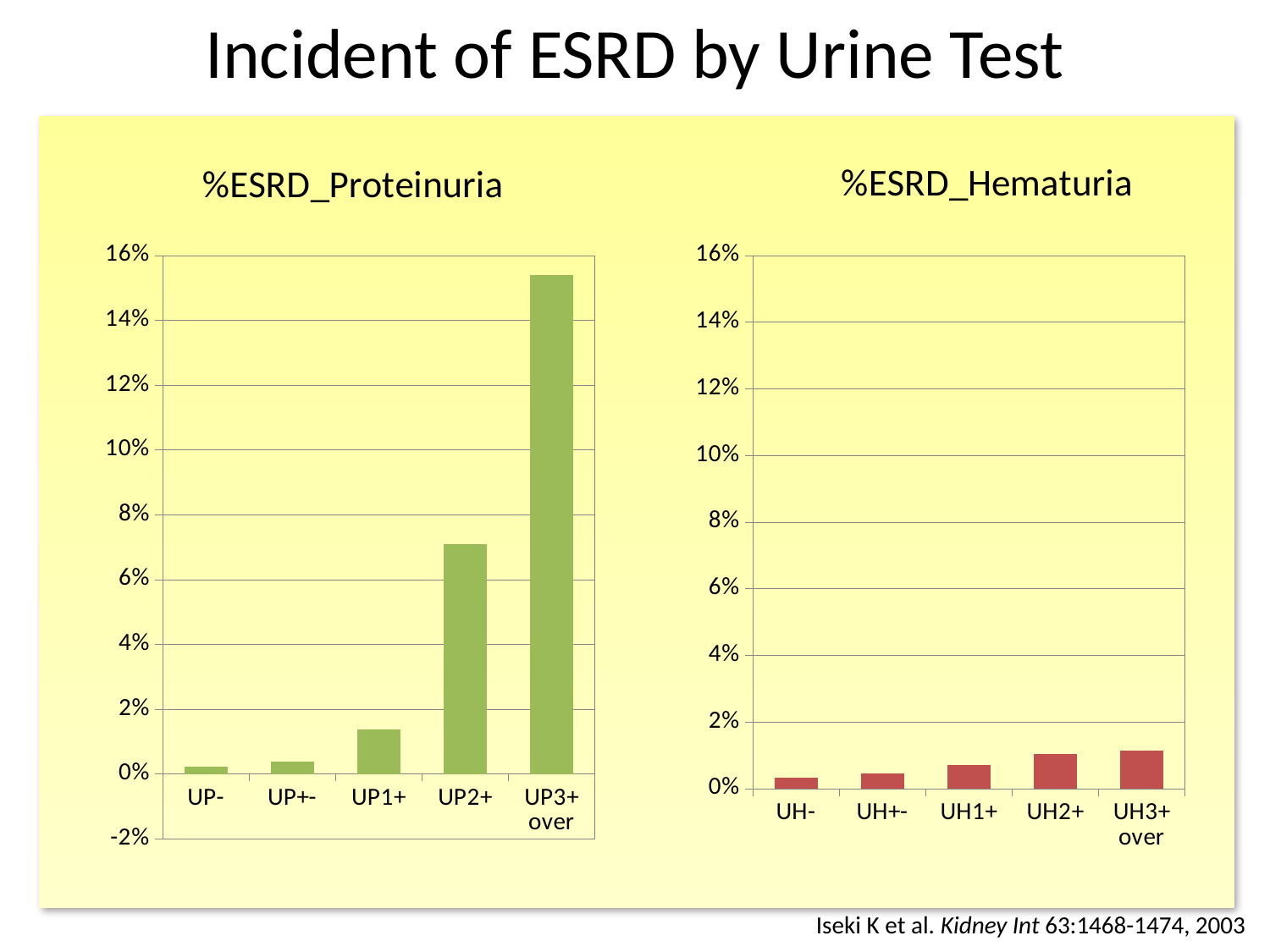
How many categories are shown on the x axis of the %ESRD_Hematuria chart? 5 In the %ESRD_Proteinuria chart, do the values rise or fall from UP- to UP3+ over? Rise In the %ESRD_Hematuria chart, is the value for UH3+ over greater or less than 2%? less In the %ESRD_Proteinuria chart, is the value for UP3+ over greater or less than 14%? greater In the %ESRD_Hematuria chart, which category has the lowest value? UH- In the %ESRD_Proteinuria chart, which category has the highest value? UP3+ over In the %ESRD_Proteinuria chart, is the value for UP2+ greater or less than 8%? less In the %ESRD_Proteinuria chart, which is larger, the value for UP2+ or the value for UP3+ over? UP3+ over What colour are the bars in the %ESRD_Hematuria chart? Red What kind of chart is the %ESRD_Proteinuria chart? Bar chart In the %ESRD_Proteinuria chart, which category has the lowest value? UP-